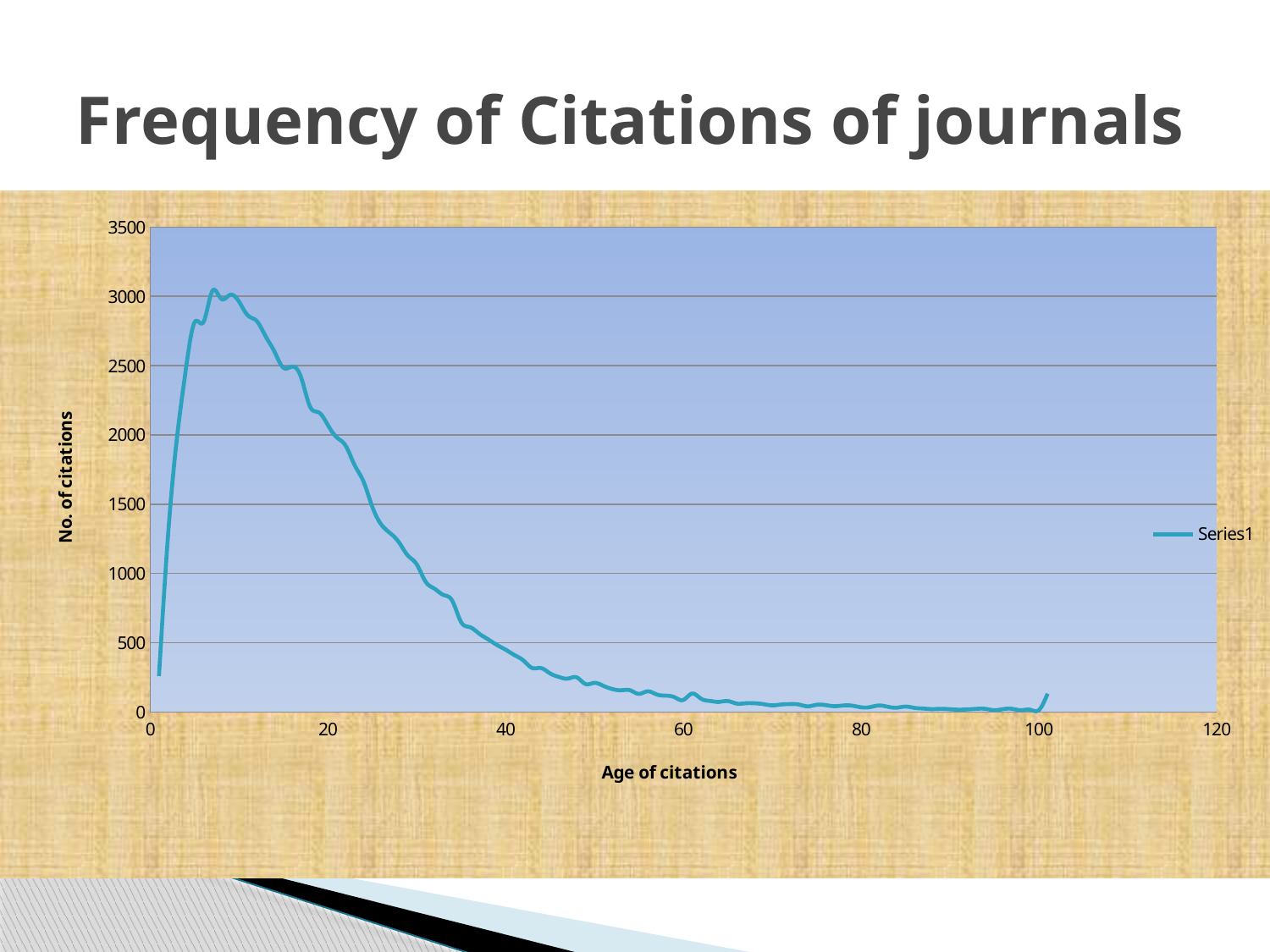
What is the title of the chart? Frequency of Citations of journals How many series does the legend list? 1 Is the value for age of citations 50 greater or less than 1000? less What is the label of the x axis? Age of citations What kind of chart is shown on the slide? line chart Is the peak value of the line greater or less than 2500? greater Is the value for age of citations 60 greater or less than 500? less Which is larger, the value at age of citations 20 or the value at age of citations 60? age of citations 20 Between age of citations 20 and 100, do the values rise or fall along the x axis? fall